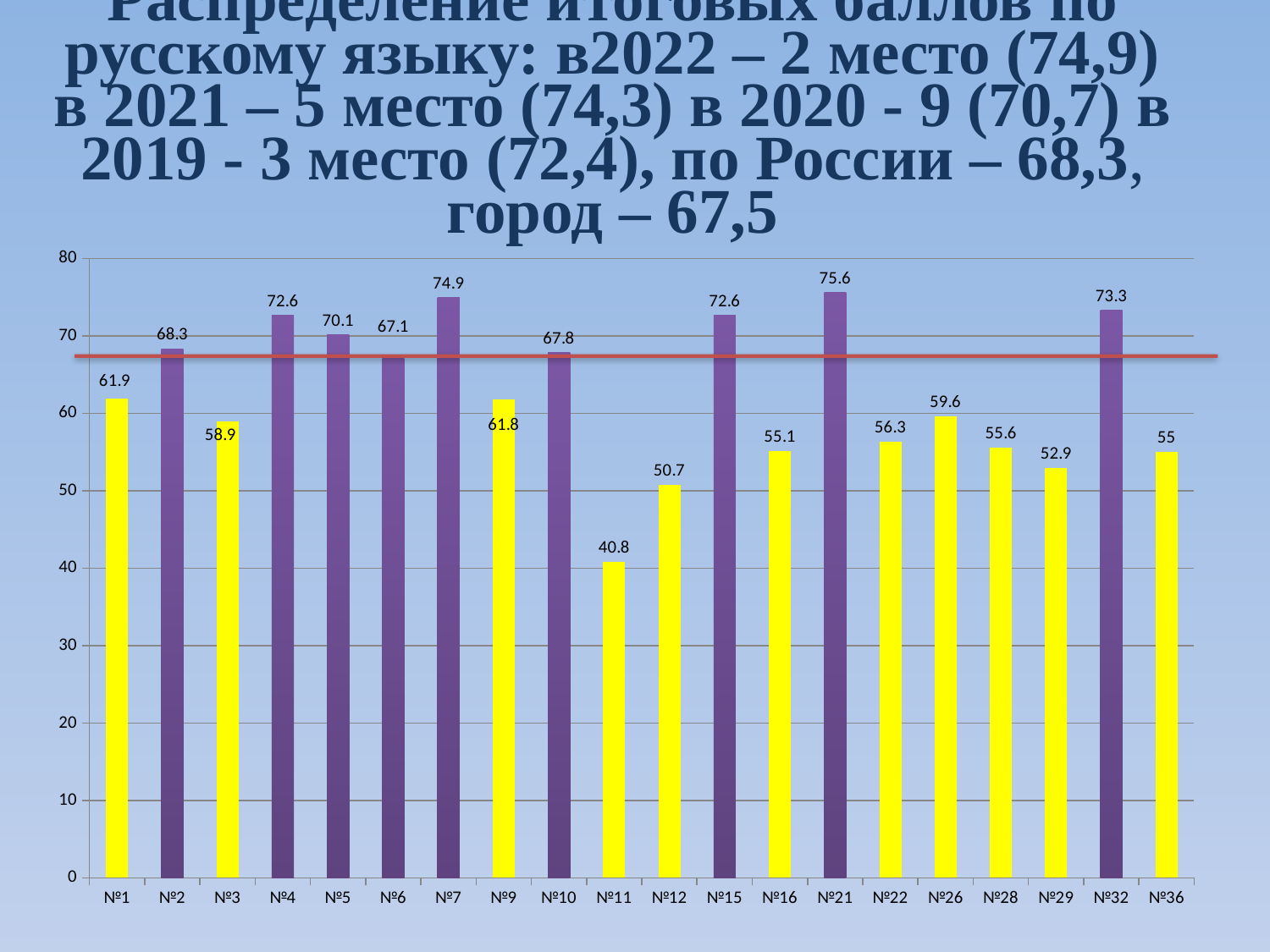
What is the value for №11? 40.8 What is the difference between the values for №4 and №3? 13.7 What is the difference between the values for №21 and №11? 34.8 Is the value for №12 greater or less than 60? less How many categories are shown on the x axis? 20 Which category has the highest value? №21 Which category has the lowest value? №11 What is the value for №7? 74.9 What kind of chart is shown on the slide? bar chart What colour are the bars for №1, №3 and №9? yellow What is the value for №32? 73.3 Which is larger, the value for №2 or the value for №10? №2